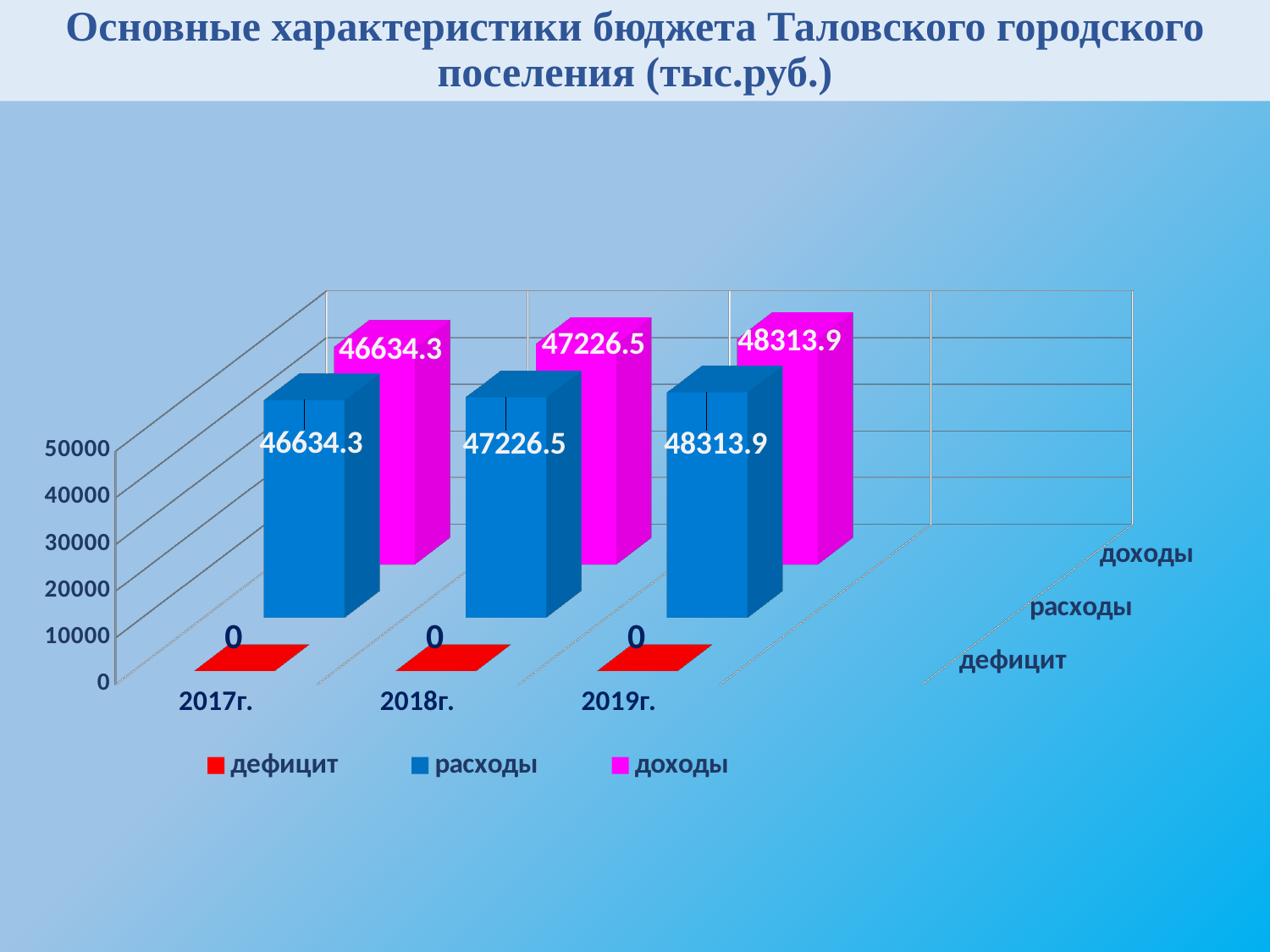
What is the value of дефицит for 2018г.? 0 Which year has the highest value of расходы? 2019г. What is the value of доходы for 2018г.? 47226.5 How many years are shown on the x axis? 3 Do the values of доходы rise or fall from 2017г. to 2019г.? rise How many series does the legend list? 3 Which is larger: расходы in 2018г. or расходы in 2019г.? расходы in 2019г. Which year has the lowest value of доходы? 2017г. What is the value of доходы for 2019г.? 48313.9 What is the difference between доходы in 2019г. and доходы in 2017г.? 1679.6 What is the value of расходы for 2017г.? 46634.3 What kind of chart is shown on the slide? bar chart